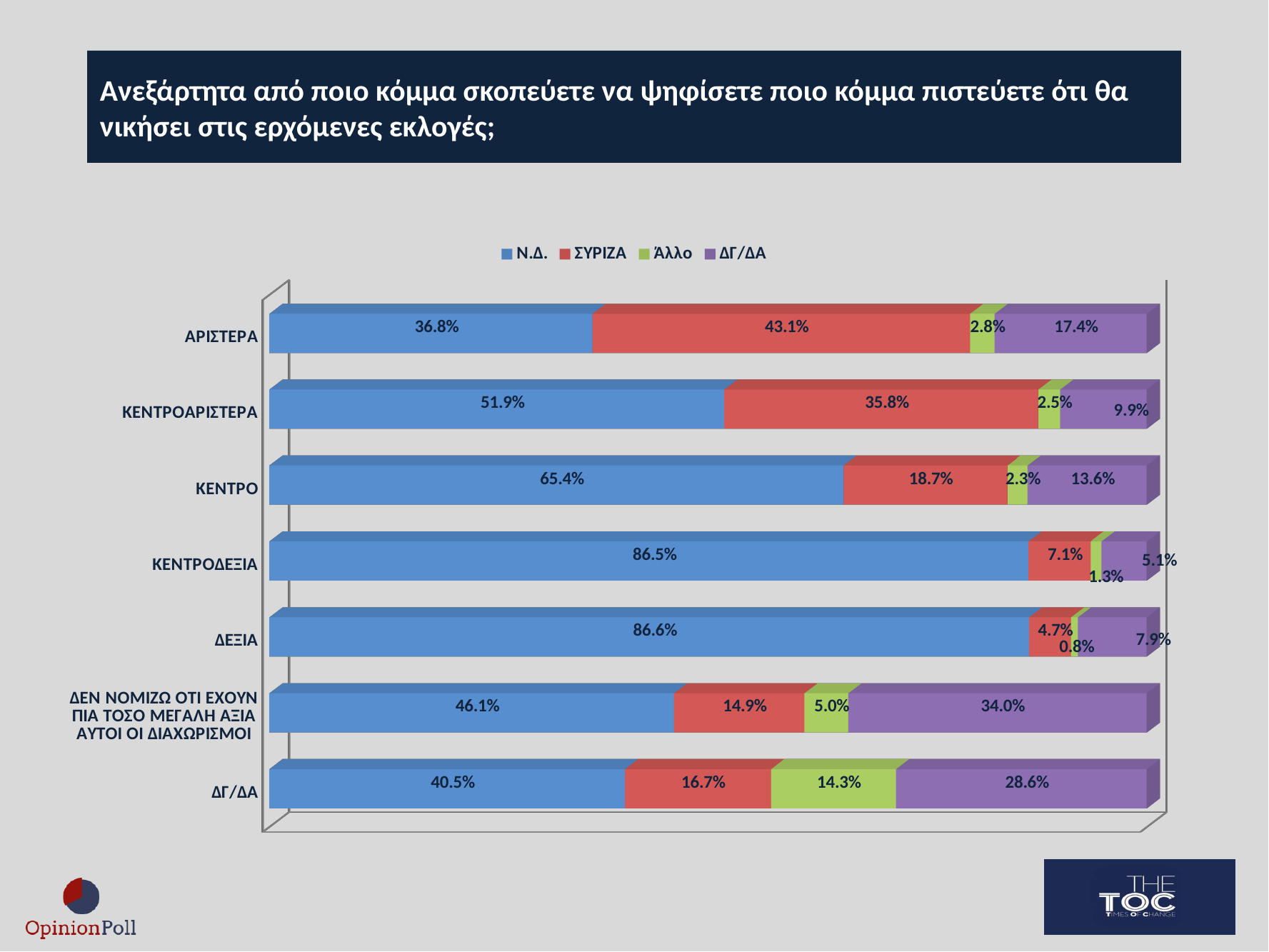
Which is larger: the Ν.Δ. value for ΚΕΝΤΡΟΑΡΙΣΤΕΡΑ or the Ν.Δ. value for ΔΓ/ΔΑ? ΚΕΝΤΡΟΑΡΙΣΤΕΡΑ What is the ΣΥΡΙΖΑ value for the ΑΡΙΣΤΕΡΑ category? 43.1% In the ΑΡΙΣΤΕΡΑ category, how much larger is the ΣΥΡΙΖΑ value than the Ν.Δ. value? 6.3 percentage points What kind of chart is shown on the slide? Stacked bar chart How many series does the legend list? 4 What percentage of ΚΕΝΤΡΟ respondents believe Ν.Δ. will win the upcoming elections? 65.4% Which category has the lowest Ν.Δ. value? ΑΡΙΣΤΕΡΑ Which category has the lowest Άλλο value? ΔΕΞΙΑ How many categories are shown on the chart? 7 What is the Άλλο value for the ΔΓ/ΔΑ category? 14.3% Which category has the highest ΣΥΡΙΖΑ value? ΑΡΙΣΤΕΡΑ What is the ΔΓ/ΔΑ value for the category 'ΔΕΝ ΝΟΜΙΖΩ ΟΤΙ ΕΧΟΥΝ ΠΙΑ ΤΟΣΟ ΜΕΓΑΛΗ ΑΞΙΑ ΑΥΤΟΙ ΟΙ ΔΙΑΧΩΡΙΣΜΟΙ'? 34.0%